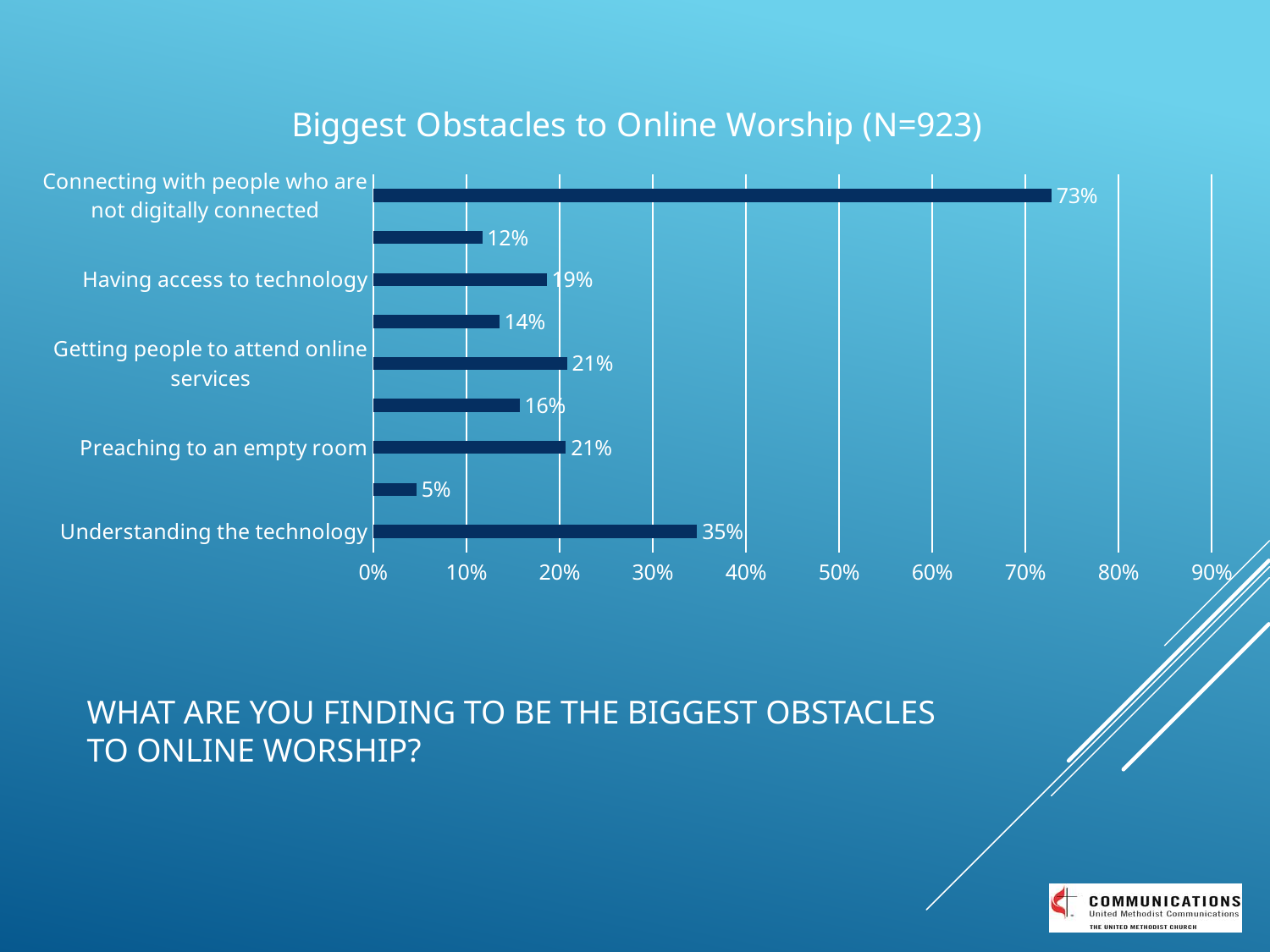
What percentage is shown for "Preaching to an empty room"? 21% What is the title of the chart? Biggest Obstacles to Online Worship (N=923) What is the smallest value shown on any bar in the chart? 5% Which is larger, the value for "Having access to technology" or the value for "Getting people to attend online services"? Getting people to attend online services How many bars are plotted in the chart? 9 What kind of chart is shown on the slide? Bar chart What percentage is shown for "Connecting with people who are not digitally connected"? 73% What percentage is shown for "Having access to technology"? 19% What is the difference between the values for "Connecting with people who are not digitally connected" and "Understanding the technology"? 38% What percentage is shown for "Understanding the technology"? 35% Is the value for "Understanding the technology" greater or less than 30%? greater Which labeled category has the highest value? Connecting with people who are not digitally connected